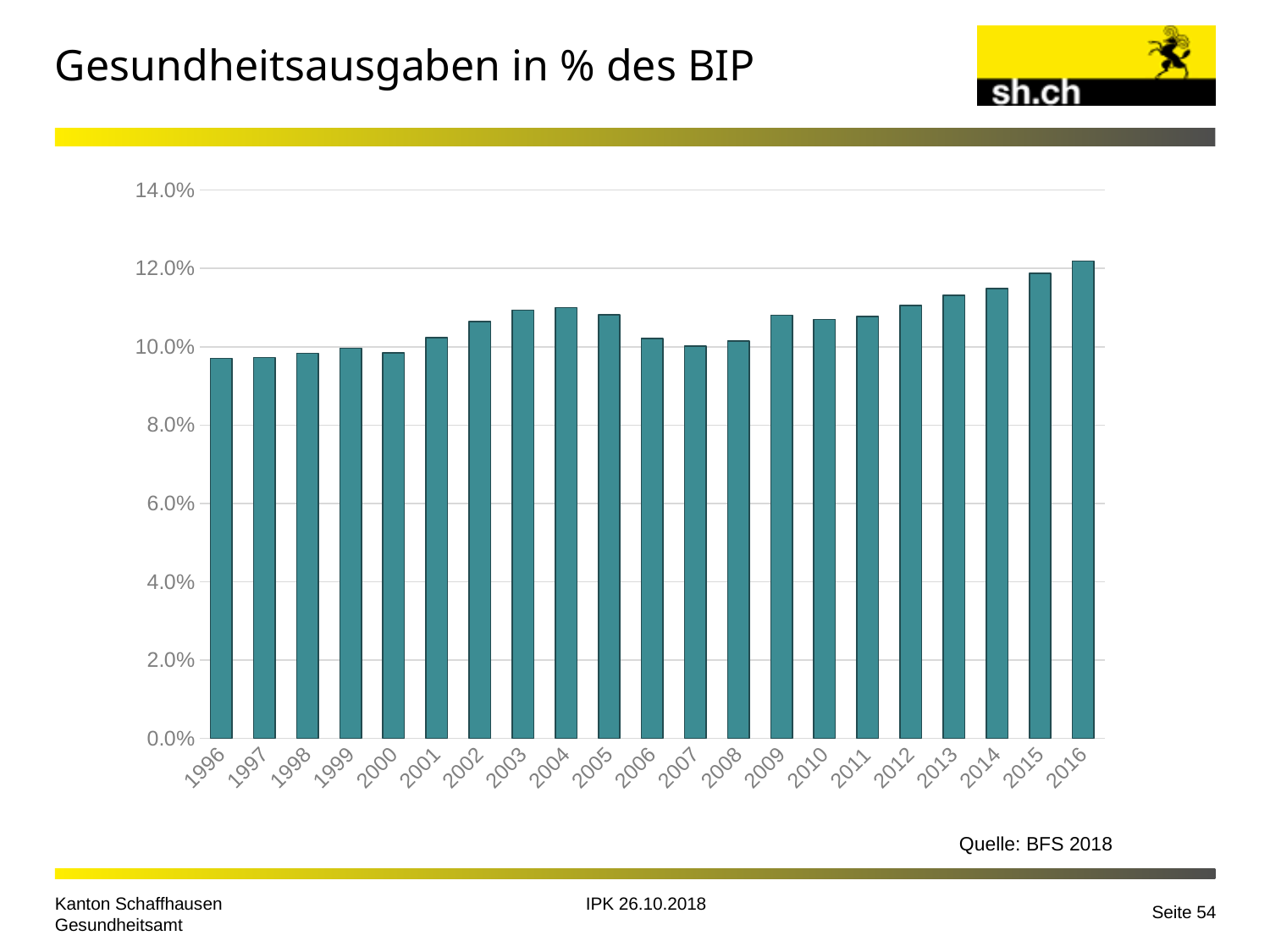
Which is larger, the value for 2004 or the value for 2007? 2004 Do the values generally rise or fall from 1996 to 2016? rise What kind of chart is shown on the slide? bar chart Is the value for 2010 greater or less than 10.0%? greater Which is larger, the value for 1996 or the value for 2016? 2016 How many years are shown on the x axis of the chart? 21 Is the value for 2013 greater or less than 11.0%? greater What is the title of the chart? Gesundheitsausgaben in % des BIP Which year has the highest value in the chart? 2016 Is the value for 2016 greater or less than 12.0%? greater What source is cited below the chart? Quelle: BFS 2018